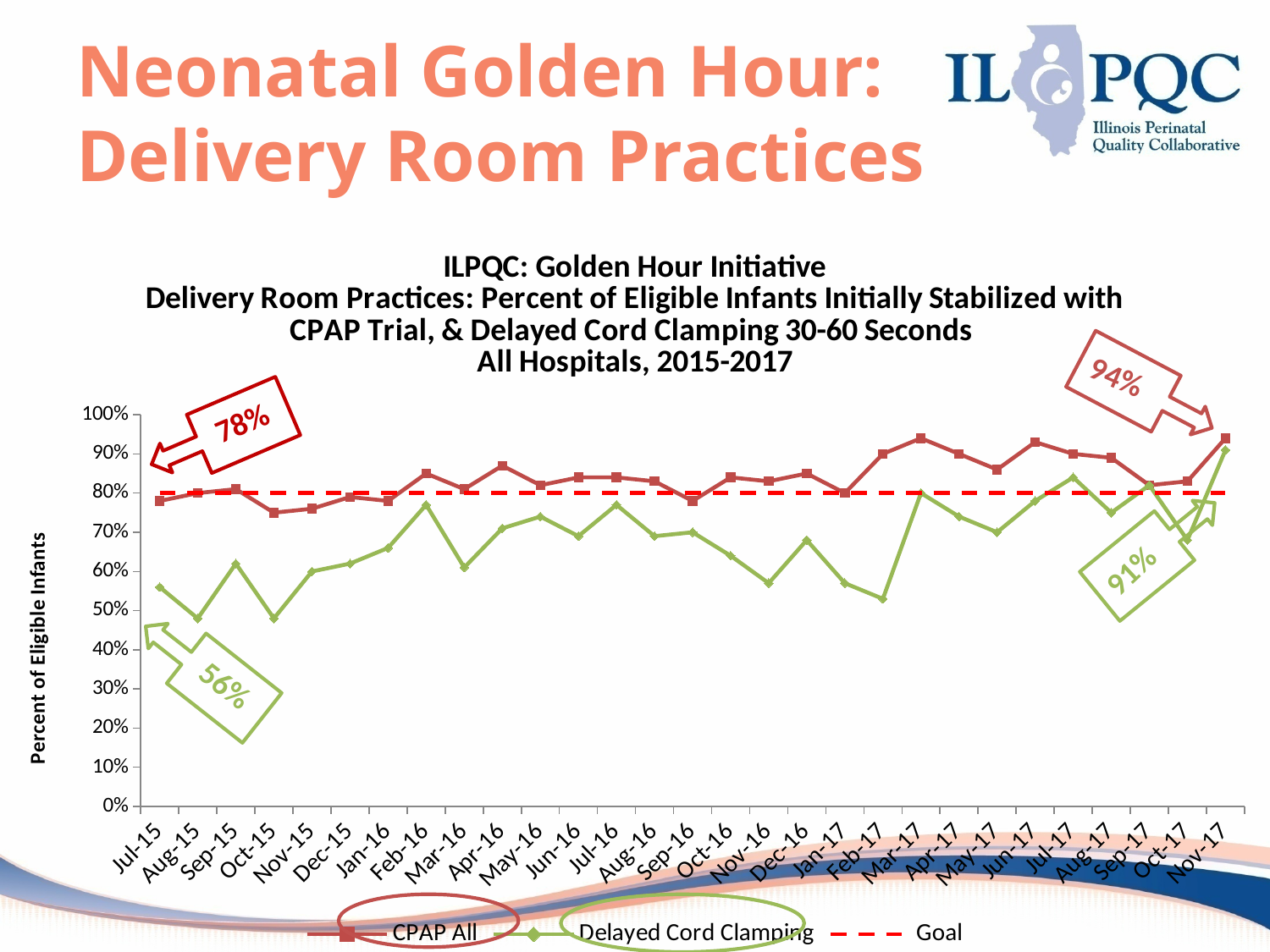
How many months are shown on the x axis? 29 What kind of chart is shown on the slide? line chart What is the Delayed Cord Clamping value for Nov-17? 91% Is the Delayed Cord Clamping value for Mar-16 greater or less than 70%? less What is the Delayed Cord Clamping value for Jul-15? 56% By how many percentage points did the Delayed Cord Clamping value increase from Jul-15 to Nov-17? 35 percentage points In Jul-15, which series had the higher value, CPAP All or Delayed Cord Clamping? CPAP All What is the CPAP All value for Jul-15? 78% How many entries does the legend list? 3 Is the CPAP All value for Mar-17 greater or less than 90%? greater What is the CPAP All value for Nov-17? 94% By how many percentage points did the CPAP All value increase from Jul-15 to Nov-17? 16 percentage points